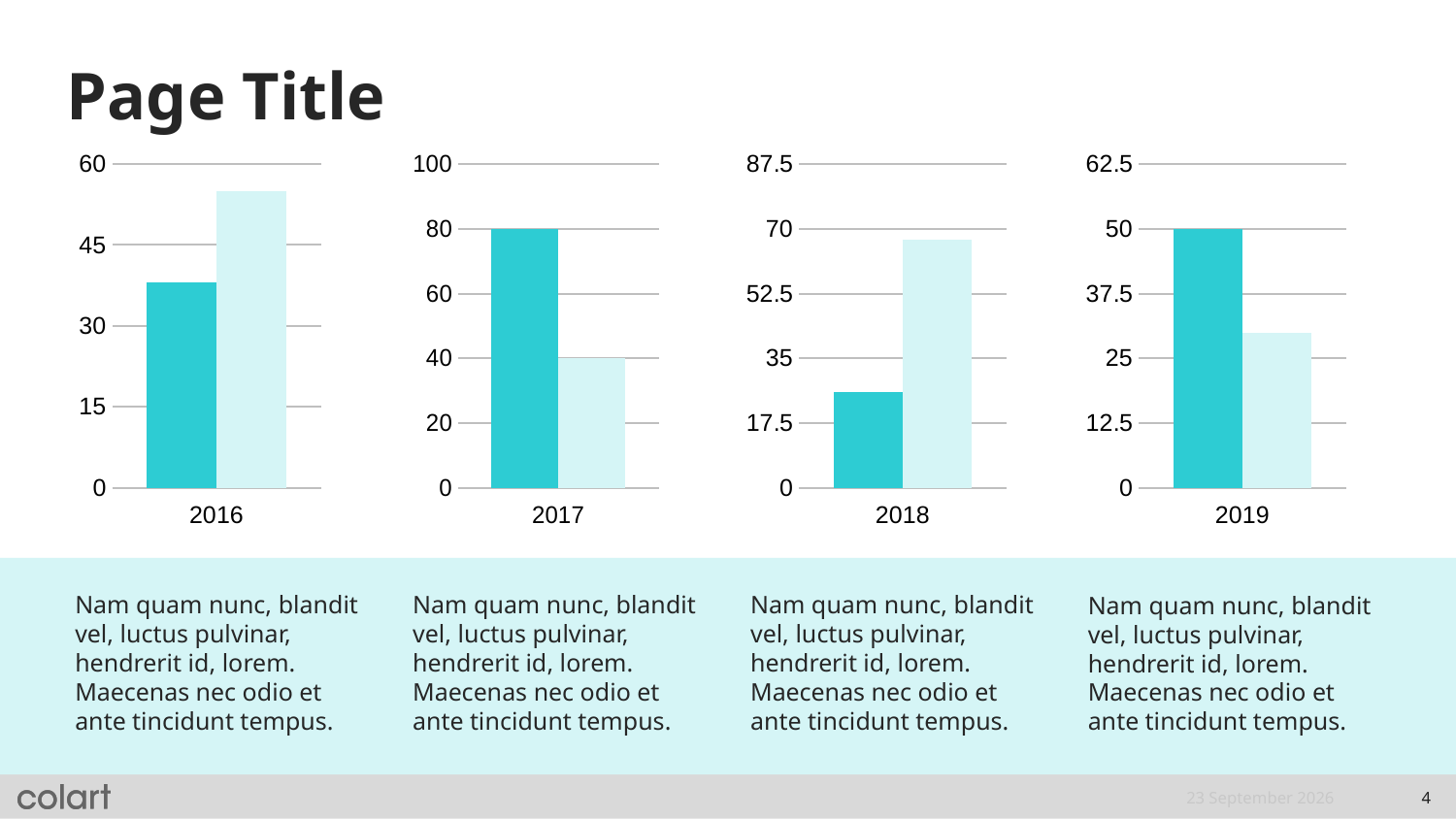
In the 2018 chart, is the value of the dark teal bar greater or less than 35? less In the 2016 chart, is the value of the light teal bar greater or less than 45? greater In the 2019 chart, what is the value of the dark teal bar? 50 In the 2017 chart, what is the difference between the dark teal bar and the light teal bar? 40 In the 2017 chart, what is the value of the dark teal bar? 80 In the 2016 chart, is the value of the dark teal bar greater or less than 45? less In the 2018 chart, which bar is taller, the dark teal bar or the light teal bar? the light teal bar How many bars does the 2017 chart show? 2 In the 2019 chart, which bar is taller, the dark teal bar or the light teal bar? the dark teal bar In the 2017 chart, what is the value of the light teal bar? 40 What kind of chart is the 2016 chart? bar chart